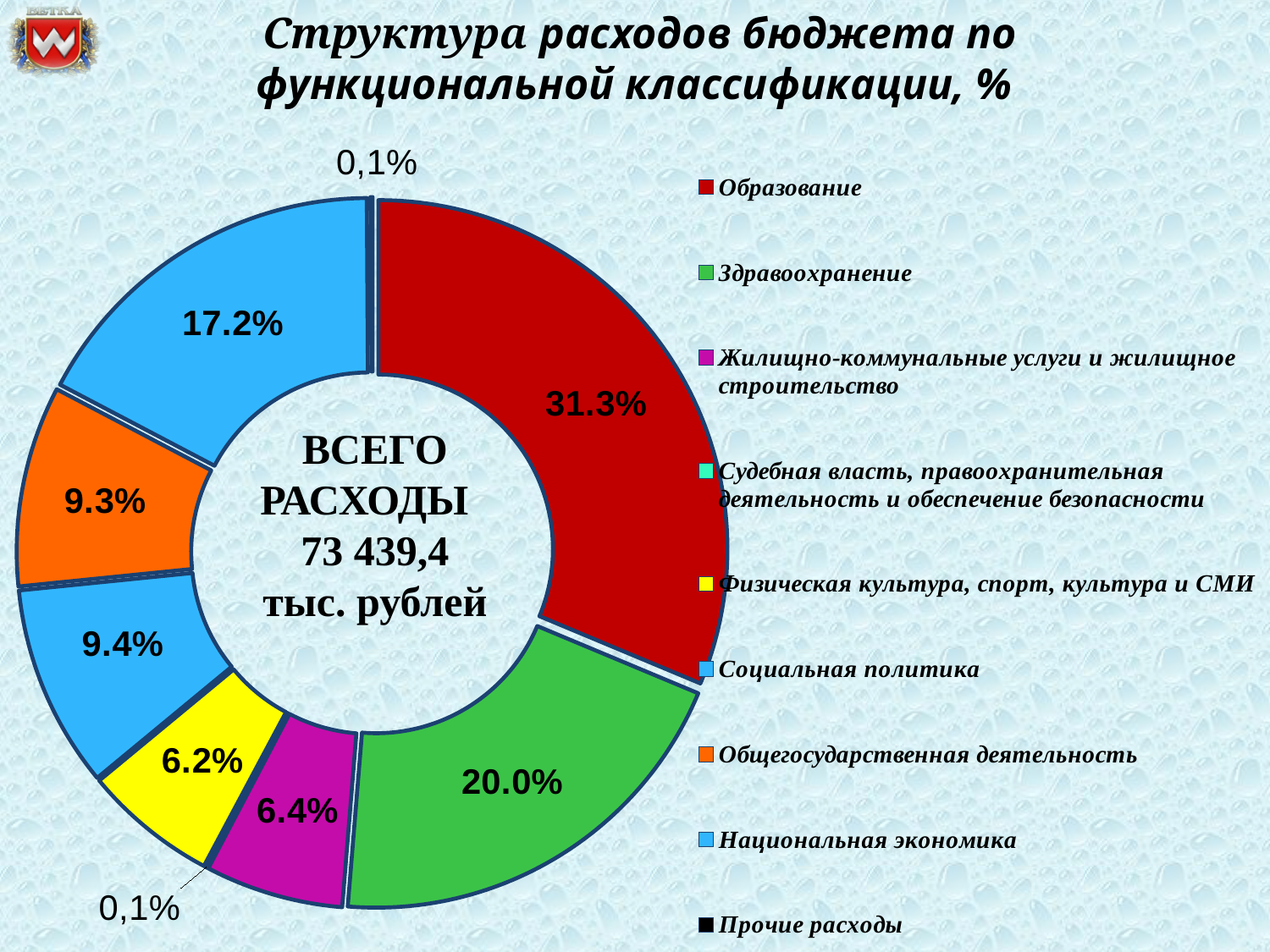
What share of budget expenditures goes to Жилищно-коммунальные услуги и жилищное строительство? 6.4% What share of budget expenditures goes to Физическая культура, спорт, культура и СМИ? 6.2% Which has a larger share: Образование or Здравоохранение? Образование What kind of chart is shown on the slide? Doughnut (pie) chart How many expenditure categories does the legend list? 9 Which expenditure category has the largest share of the budget? Образование What share of budget expenditures goes to Образование? 31.3% What total expenditure amount is shown in the centre of the chart? 73 439,4 тыс. рублей By how many percentage points does the share of Образование exceed the share of Здравоохранение? 11.3 What is the title of the chart? Структура расходов бюджета по функциональной классификации, % Which has a larger share: Жилищно-коммунальные услуги и жилищное строительство or Физическая культура, спорт, культура и СМИ? Жилищно-коммунальные услуги и жилищное строительство What share of budget expenditures goes to Здравоохранение? 20.0%